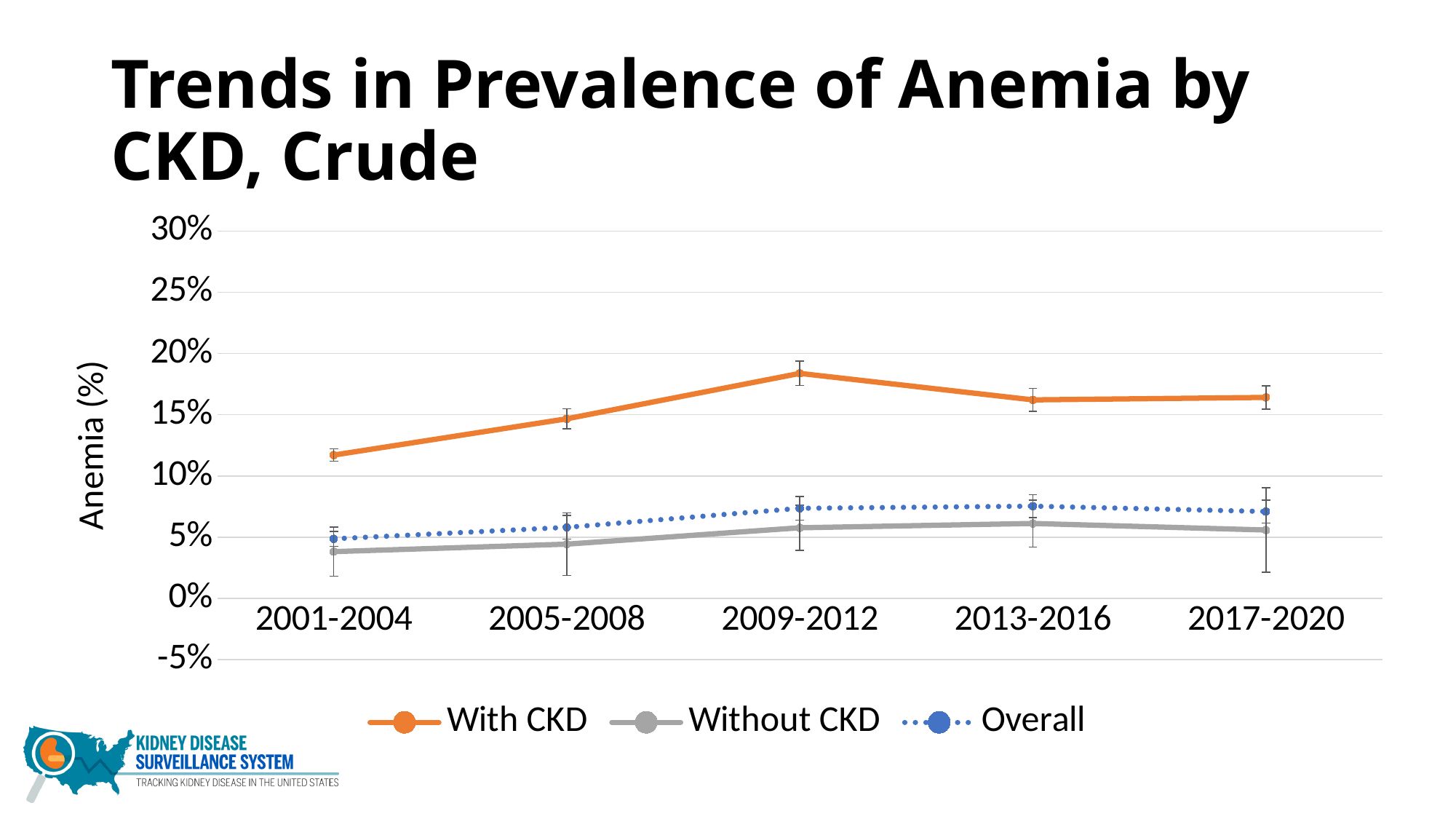
In which time period is the With CKD series lowest? 2001-2004 What is the label on the y axis? Anemia (%) In which time period is the With CKD series highest? 2009-2012 Is the value for With CKD in 2001-2004 greater or less than 10%? greater How many time periods are shown on the x axis? 5 Is the value for With CKD in 2009-2012 greater or less than 20%? less How many series does the legend list? 3 Which series has the larger value in 2009-2012, With CKD or Without CKD? With CKD Does the With CKD series rise or fall from 2001-2004 to 2009-2012? Rise Is the value for Without CKD in 2001-2004 greater or less than 5%? less What kind of chart is shown on the slide? Line chart In which time period is the Without CKD series lowest? 2001-2004